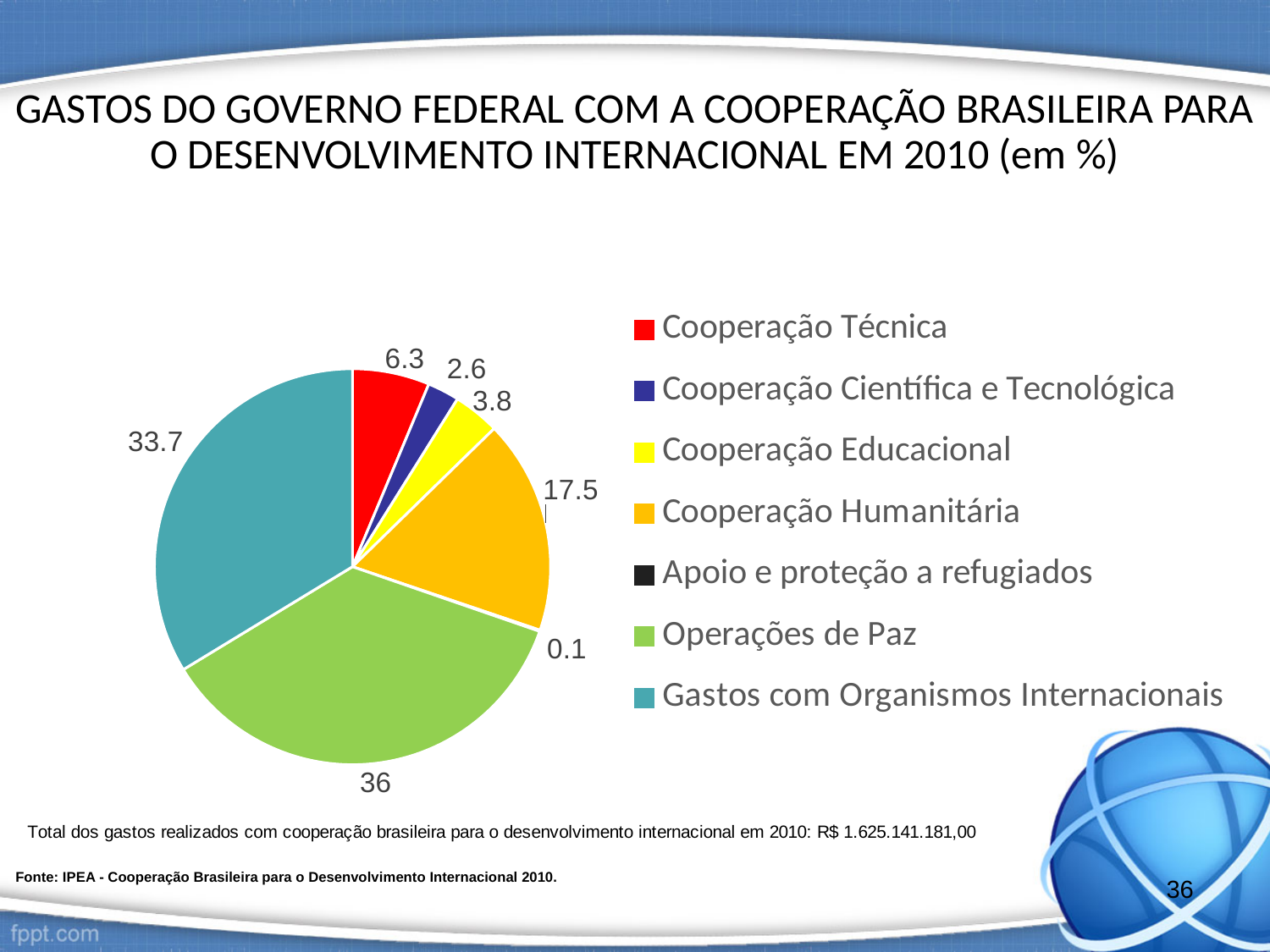
What is the combined value of Cooperação Técnica and Cooperação Educacional? 10.1 Which category has the largest share of the pie? Operações de Paz What is the difference between the values for Operações de Paz and Gastos com Organismos Internacionais? 2.3 Which is larger, Cooperação Educacional or Cooperação Científica e Tecnológica? Cooperação Educacional What kind of chart is shown on the slide? pie chart What is the value for Gastos com Organismos Internacionais? 33.7 What is the value for Cooperação Humanitária? 17.5 What is the value for Apoio e proteção a refugiados? 0.1 How many categories does the legend list? 7 What colour represents Cooperação Humanitária in the pie chart? orange What is the value for Cooperação Técnica? 6.3 Which category has the smallest share of the pie? Apoio e proteção a refugiados